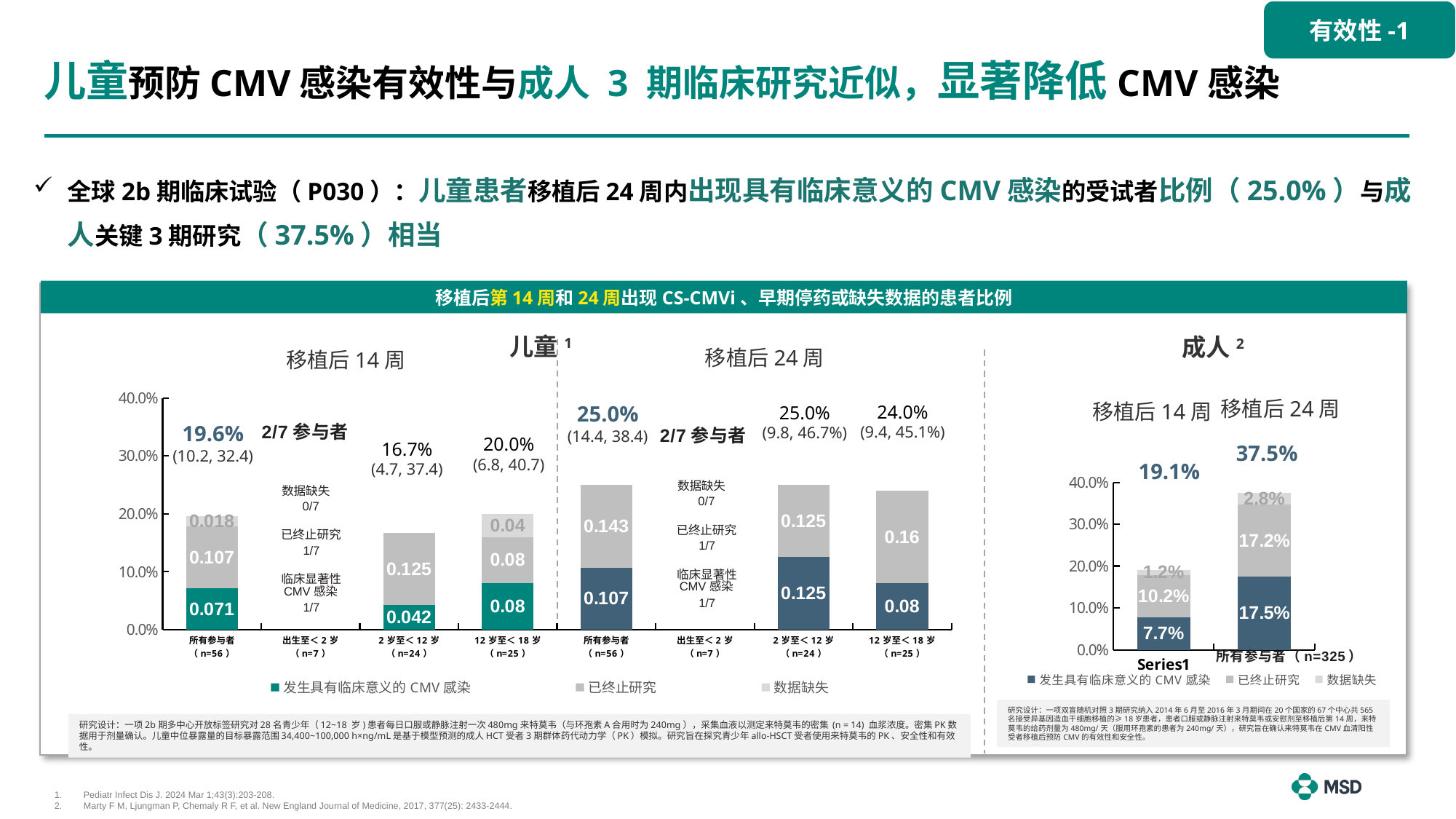
In the children's chart (儿童) at 移植后 24 周, which has the larger 发生具有临床意义的 CMV 感染 segment: 所有参与者 (n=56) or 12 岁至< 18 岁 (n=25)? 所有参与者 (n=56) In the adult chart (成人), which time point has the higher total: 移植后 14 周 or 移植后 24 周? 移植后 24 周 What kind of chart is used for the children's data (儿童)? Stacked bar chart How many series does the legend of the children's chart (儿童) list? 3 In the adult chart (成人), what is the difference between the 已终止研究 segment at 移植后 24 周 and at 移植后 14 周? 7.0 percentage points In the children's chart (儿童), what is the total percentage shown above the 12 岁至< 18 岁 (n=25) bar at 移植后 14 周? 20.0% In the children's chart (儿童), what is the value of the 已终止研究 segment for 12 岁至< 18 岁 (n=25) at 移植后 24 周? 0.16 In the adult chart (成人), what is the difference between the total at 移植后 24 周 (37.5%) and the total at 移植后 14 周 (19.1%)? 18.4 percentage points In the adult chart (成人), what is the value of the 数据缺失 segment at 移植后 14 周? 1.2% In the adult chart (成人), what is the value of the 发生具有临床意义的 CMV 感染 segment at 移植后 24 周? 17.5% In the children's chart (儿童), what is the value of the 发生具有临床意义的 CMV 感染 segment for 所有参与者 (n=56) at 移植后 14 周? 0.071 In the children's chart (儿童), what is the value of the 已终止研究 segment for 2 岁至< 12 岁 (n=24) at 移植后 24 周? 0.125